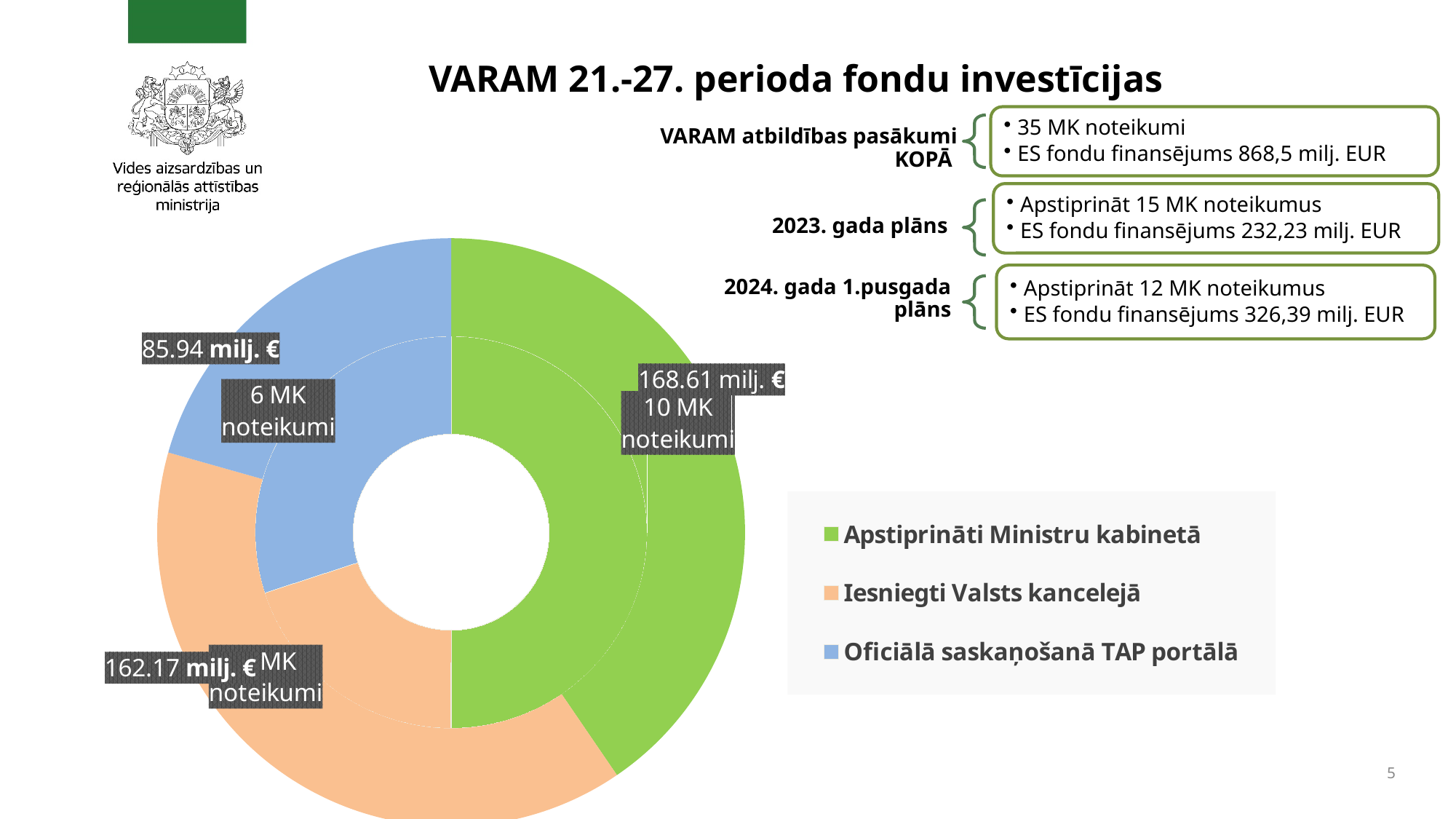
Which is larger in milj. €: Iesniegti Valsts kancelejā or Oficiālā saskaņošanā TAP portālā? Iesniegti Valsts kancelejā What is the value in milj. € for Iesniegti Valsts kancelejā? 162.17 milj. € What is the value in milj. € for Apstiprināti Ministru kabinetā? 168.61 milj. € How many categories does the chart show? 3 Which category has the highest value in milj. €? Apstiprināti Ministru kabinetā How many MK noteikumi are shown for Apstiprināti Ministru kabinetā? 10 MK noteikumi Which category has the lowest value in milj. €? Oficiālā saskaņošanā TAP portālā What is the value in milj. € for Oficiālā saskaņošanā TAP portālā? 85.94 milj. € What kind of chart is shown on the slide? doughnut chart How many MK noteikumi are shown for Oficiālā saskaņošanā TAP portālā? 6 MK noteikumi What is the difference in milj. € between Apstiprināti Ministru kabinetā and Oficiālā saskaņošanā TAP portālā? 82.67 milj. € What is the total of the three milj. € values shown on the chart? 416.72 milj. €